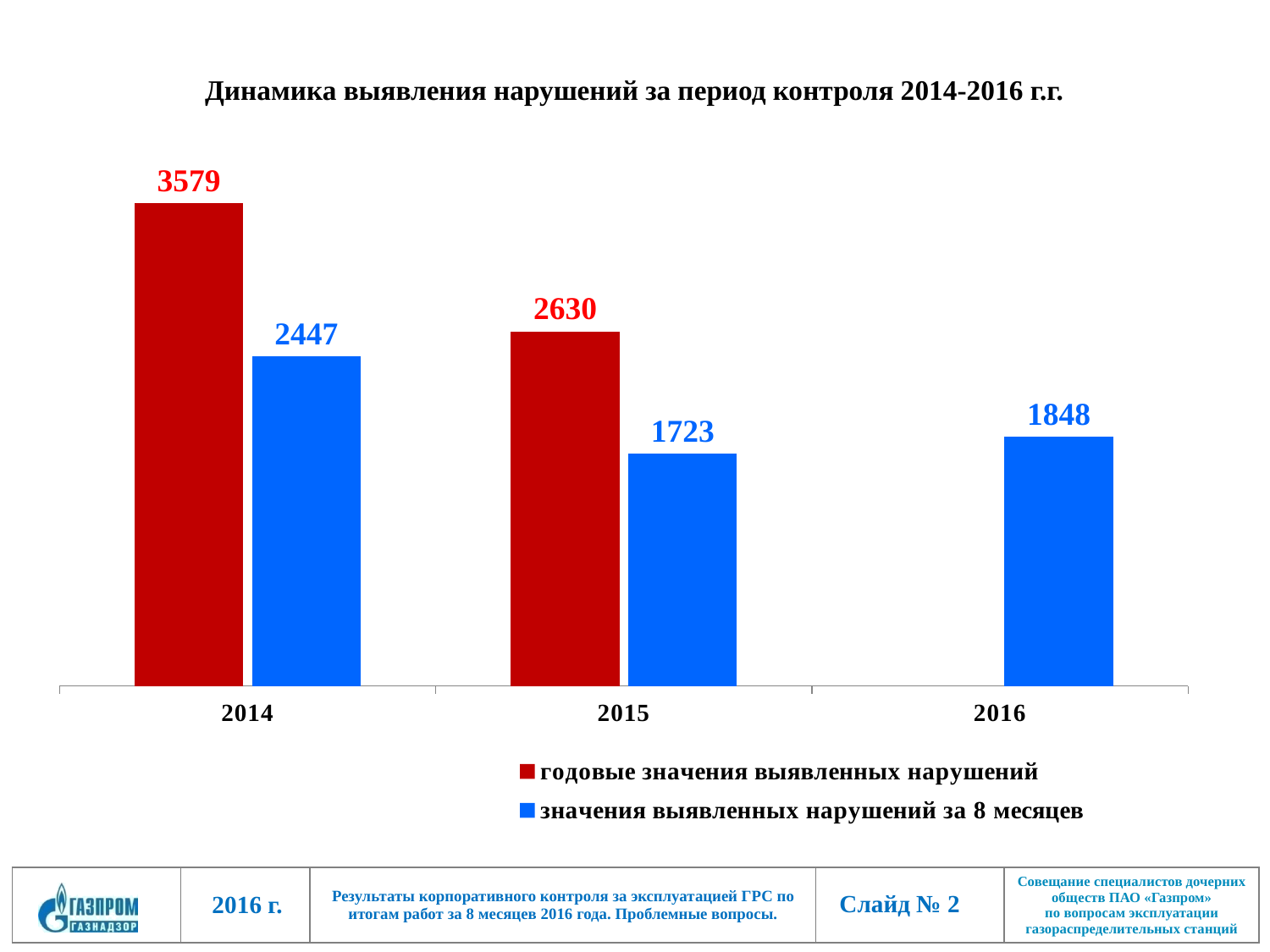
What is the annual value of identified violations (годовые значения выявленных нарушений) for 2014? 3579 What is the value of identified violations for 8 months (значения выявленных нарушений за 8 месяцев) in 2015? 1723 What kind of chart is shown on the slide? Bar chart What is the difference between the annual values of identified violations for 2014 and 2015? 949 How many series does the legend list? 2 What is the difference between the 8-month values of identified violations for 2016 and 2015? 125 Which year has the lowest value of identified violations for 8 months? 2015 Which year has the highest annual value of identified violations? 2014 What is the annual value of identified violations for 2015? 2630 What is the value of identified violations for 8 months in 2016? 1848 Does the annual value of identified violations rise or fall from 2014 to 2015? Fall Which is larger: the 8-month value for 2014 or the 8-month value for 2016? 2014